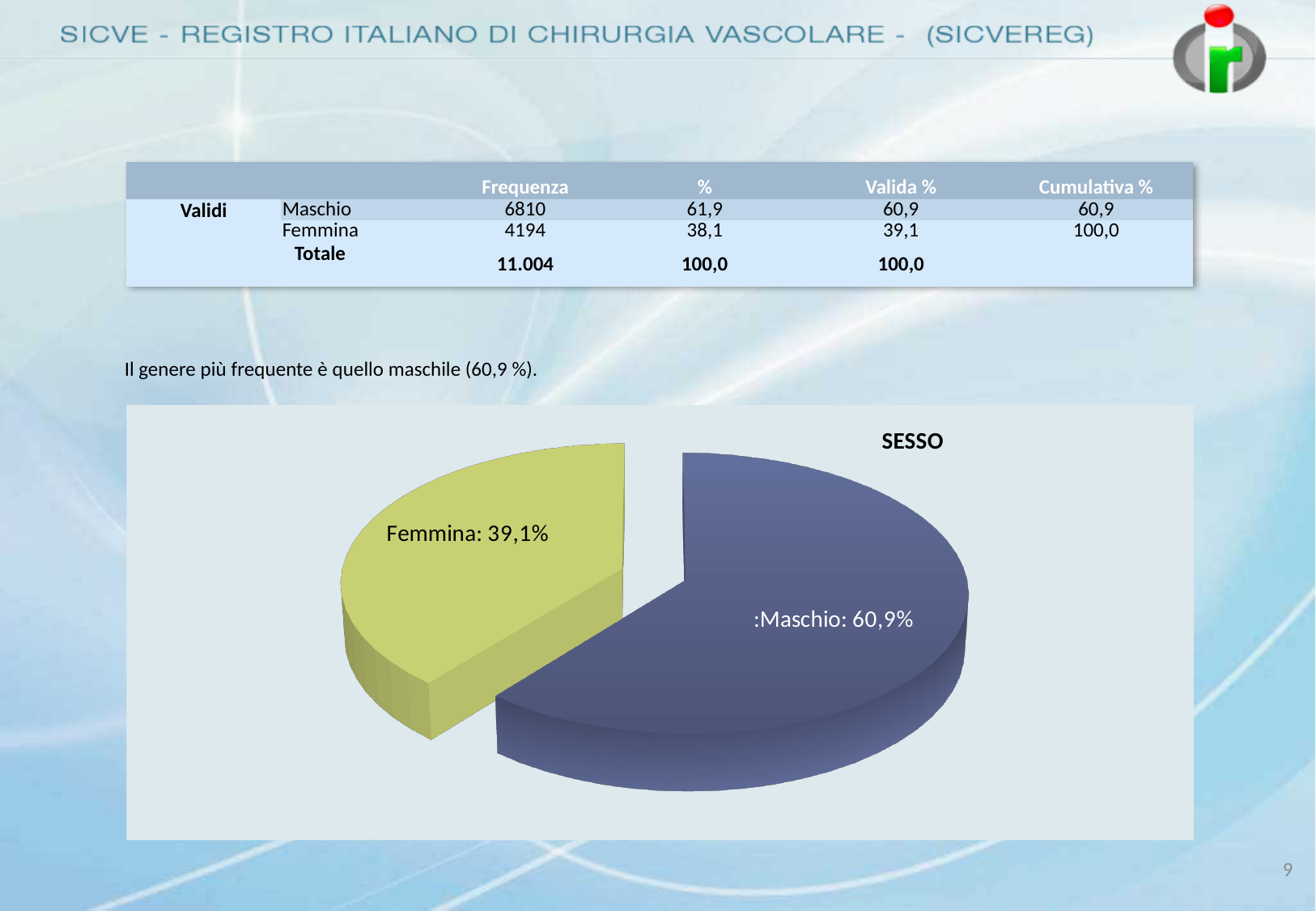
Which category has the largest slice in the pie chart? Maschio What share of the pie chart does Femmina represent? 39,1% Which slice is larger, Maschio or Femmina? Maschio How many slices does the pie chart have? 2 What is the title of the pie chart? SESSO Which category has the smallest slice in the pie chart? Femmina What colour is the Femmina slice in the pie chart? Yellow-green What share of the pie chart does Maschio represent? 60,9% What is the difference in percentage points between the Maschio and Femmina slices? 21,8 What kind of chart is shown on the slide? Pie chart Is the share for Femmina greater or less than 50%? less